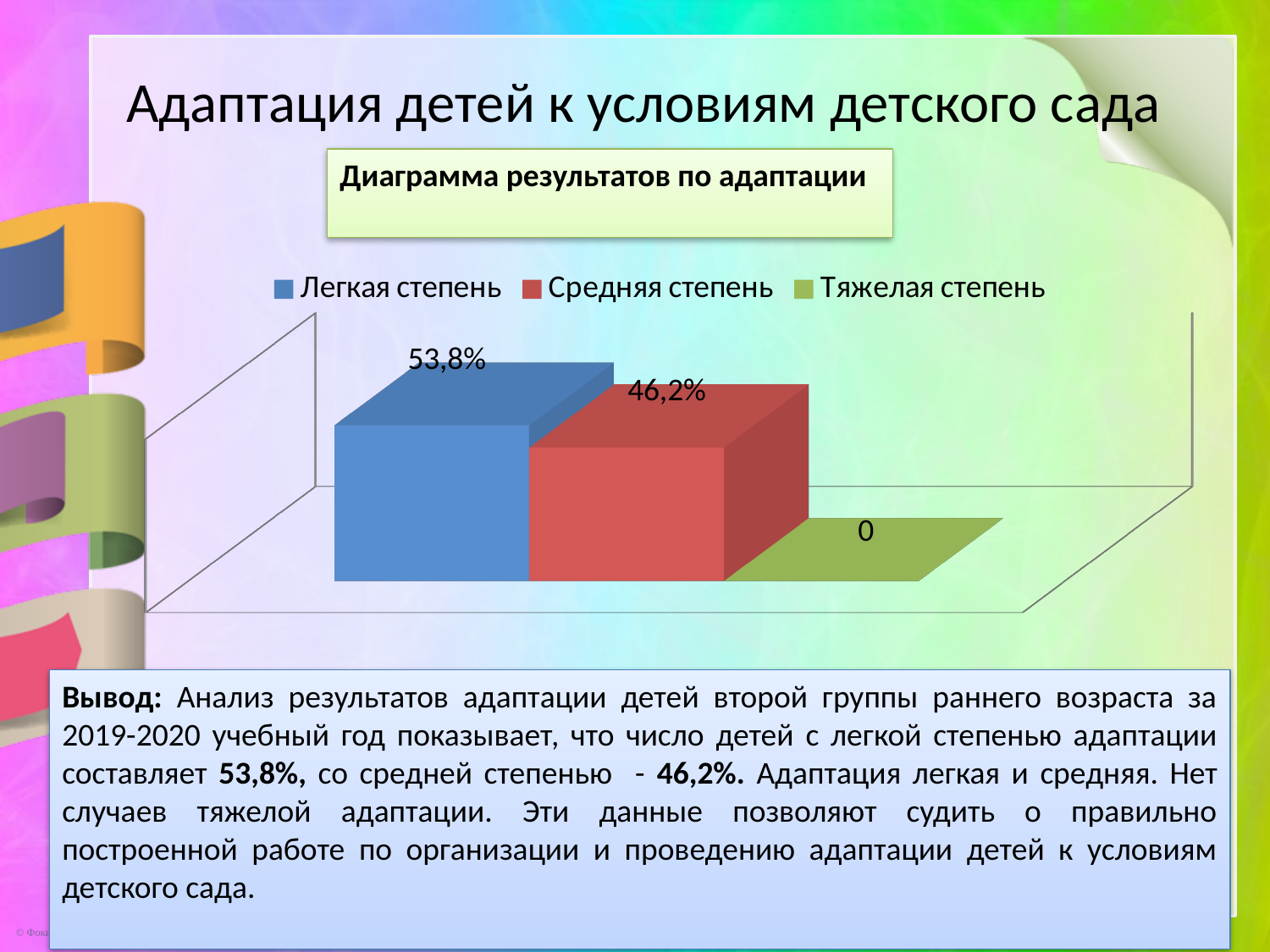
What kind of chart is shown on the slide? Bar chart How many series does the legend list? 3 What is the value for Легкая степень? 53,8% What is the value for Средняя степень? 46,2% Which series has the lowest value? Тяжелая степень What is the value for Тяжелая степень? 0 What colour is the bar for Средняя степень? Red Which series has the highest value? Легкая степень Which is larger, the value for Легкая степень or the value for Средняя степень? Легкая степень What is the difference between the values for Легкая степень and Средняя степень? 7,6% What is the title shown above the chart? Диаграмма результатов по адаптации